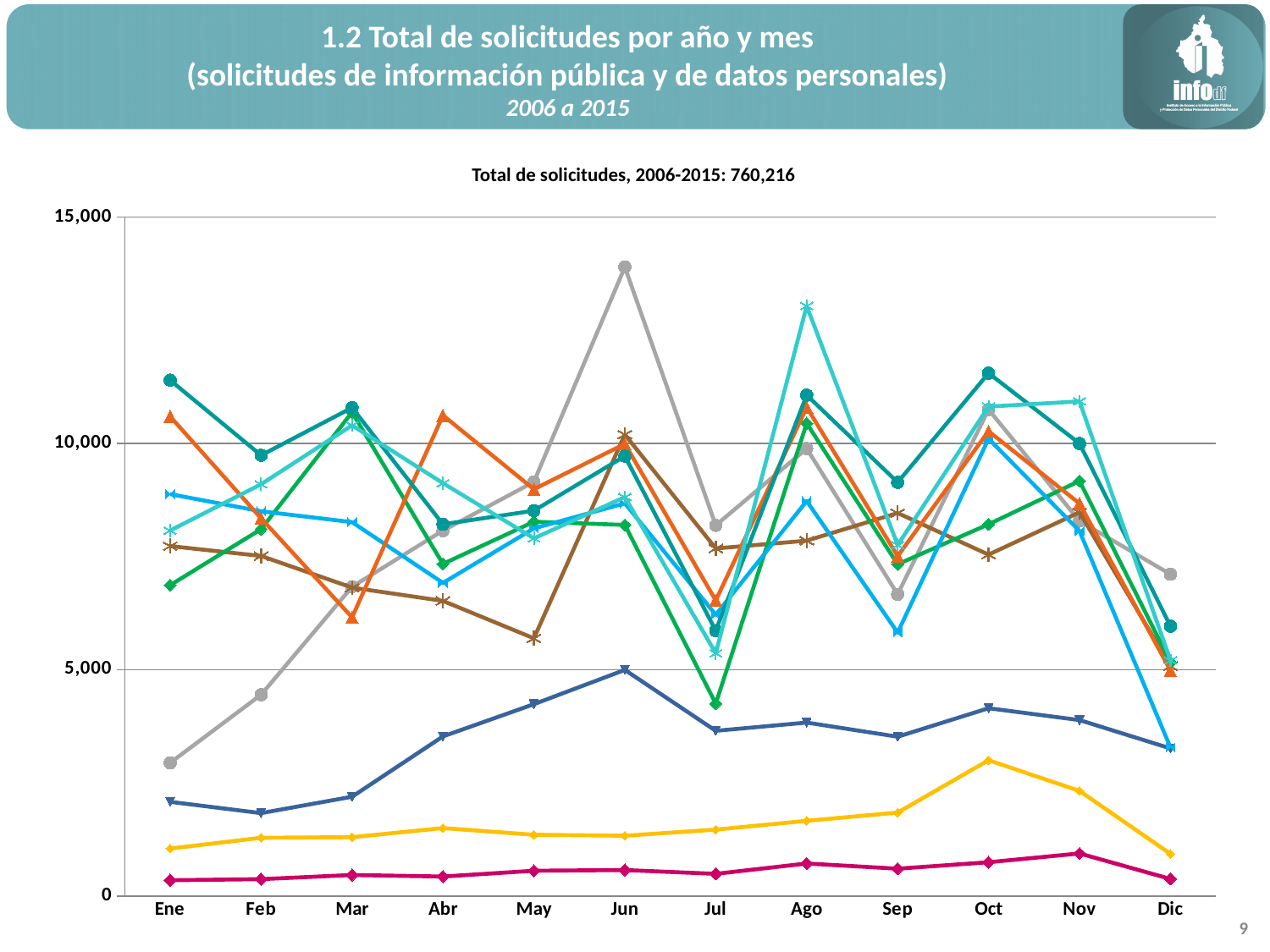
In which month does the highest point on the chart occur? Jun What total of solicitudes for 2006-2015 is printed above the chart? 760,216 What is the highest value shown on the y axis of the chart? 15,000 Is the highest point on the chart greater or less than 10,000? greater What is the last month label on the x axis of the chart? Dic How many months are shown along the x axis of the chart? 12 What is the first month label on the x axis of the chart? Ene What kind of chart is shown on the slide? line chart